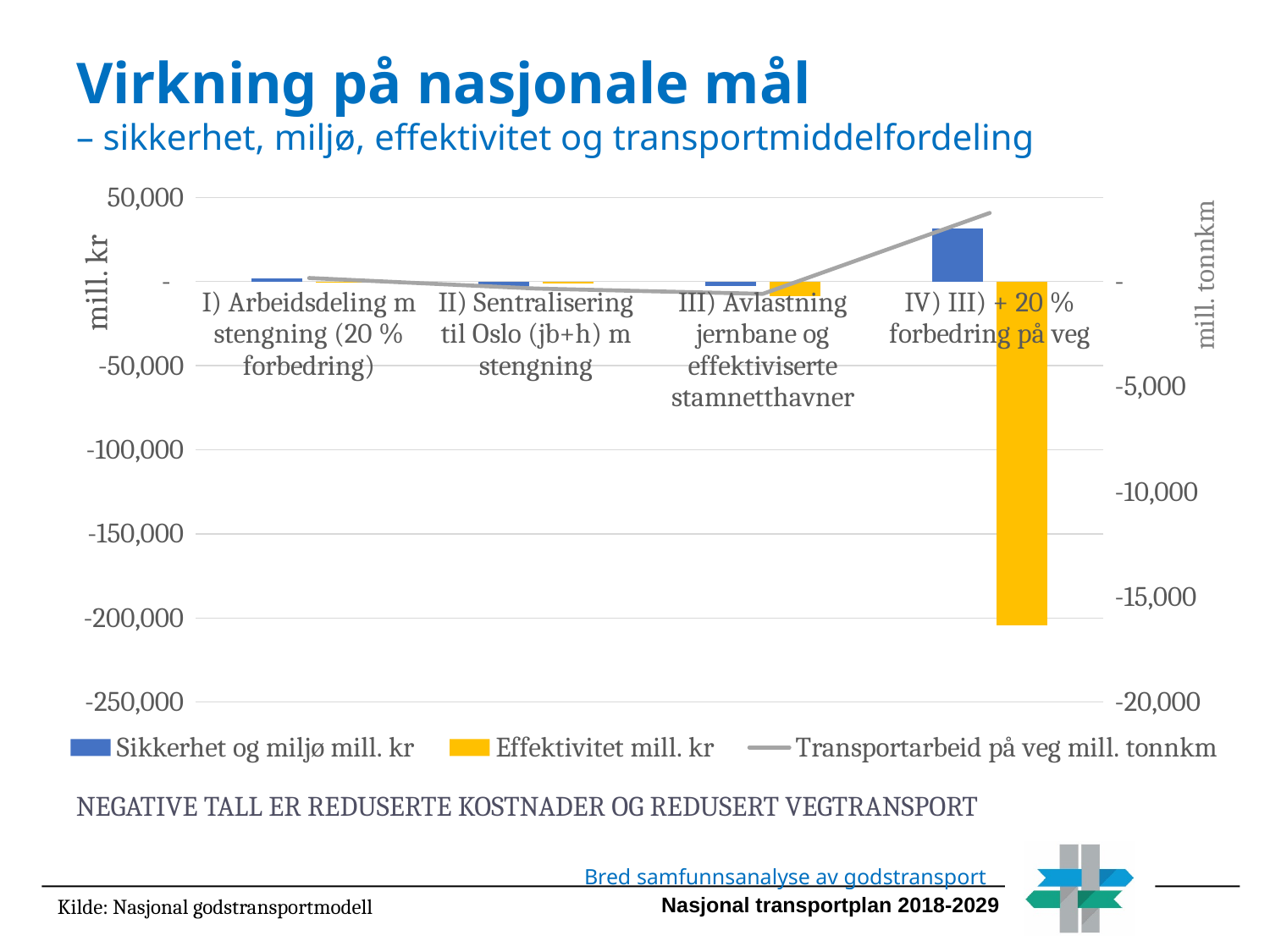
For IV) III) + 20 % forbedring på veg, which is larger: the Sikkerhet og miljø mill. kr value or the Effektivitet mill. kr value? Sikkerhet og miljø mill. kr How many categories are shown on the x axis? 4 How many series does the legend list? 3 Is the Effektivitet mill. kr value for IV) III) + 20 % forbedring på veg greater or less than -150,000? less What is the label on the left vertical axis? mill. kr What note is printed below the chart legend? NEGATIVE TALL ER REDUSERTE KOSTNADER OG REDUSERT VEGTRANSPORT Is the Sikkerhet og miljø mill. kr value for IV) III) + 20 % forbedring på veg greater or less than 50,000? less Is the Sikkerhet og miljø mill. kr value for IV) III) + 20 % forbedring på veg greater or less than 0? greater What kind of chart is shown on the slide? A bar chart combined with a line Which category has the highest value for Sikkerhet og miljø mill. kr? IV) III) + 20 % forbedring på veg Which category has the lowest value for Effektivitet mill. kr? IV) III) + 20 % forbedring på veg Does the Transportarbeid på veg mill. tonnkm line rise or fall between category III and category IV? rise